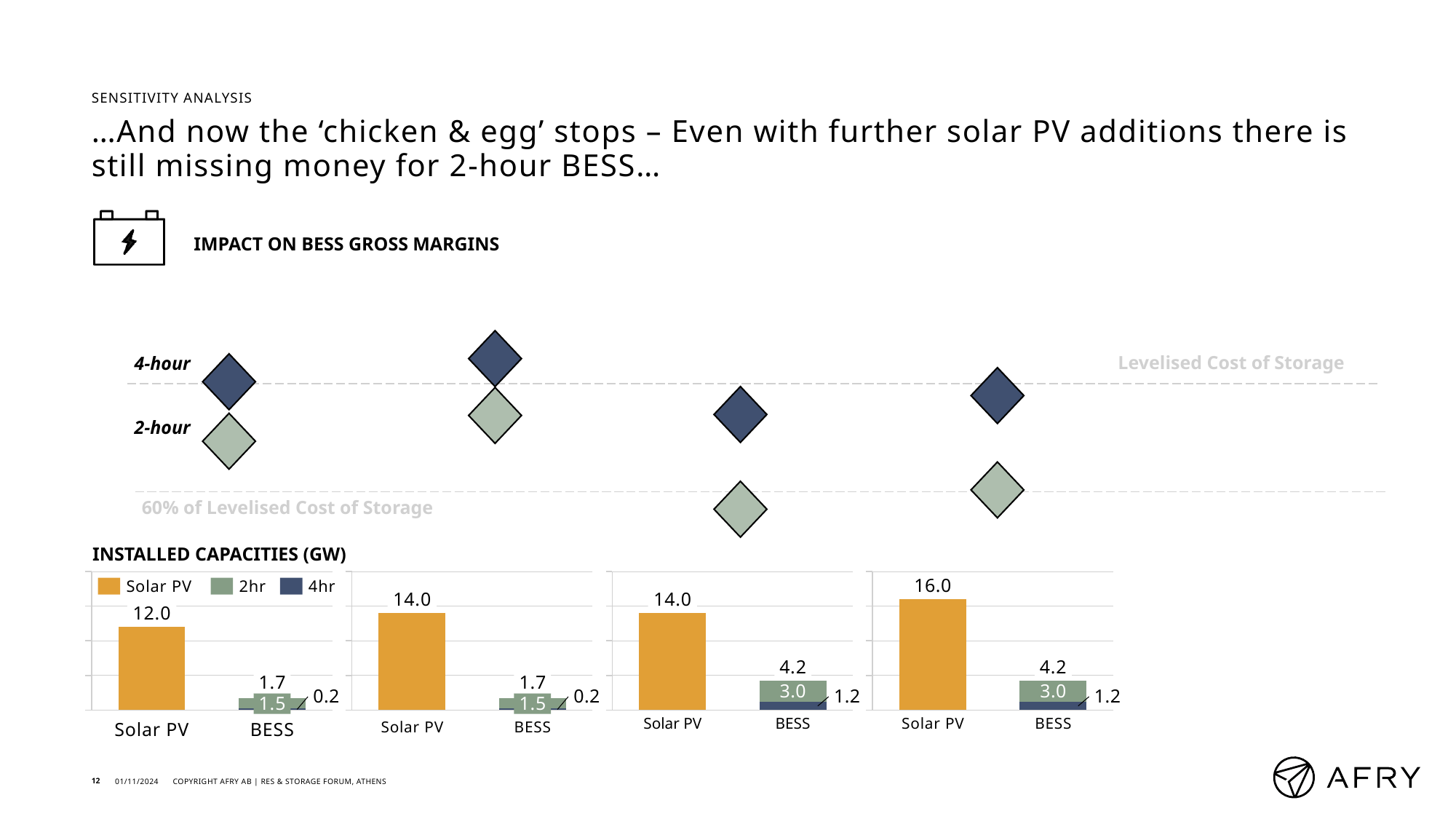
In the second installed capacities chart from the left, what is the 4hr value for BESS? 0.2 What kind of chart are the installed capacities charts? Bar chart In the rightmost installed capacities chart, what is the value for Solar PV? 16.0 In the leftmost installed capacities chart, what is the difference between the Solar PV value and the BESS total? 10.3 In the leftmost installed capacities chart, what is the value for Solar PV? 12.0 What unit is given in the title of the installed capacities charts? GW In the rightmost installed capacities chart, which is larger, the Solar PV value or the BESS total? Solar PV How many series does the legend of the installed capacities charts list? 3 In the rightmost installed capacities chart, what is the total of the stacked BESS bar? 4.2 How many categories are shown on the x axis of the leftmost installed capacities chart? 2 In the third installed capacities chart from the left, what is the 2hr value for BESS? 3.0 In the third installed capacities chart from the left, what is the difference between the 2hr and 4hr values for BESS? 1.8